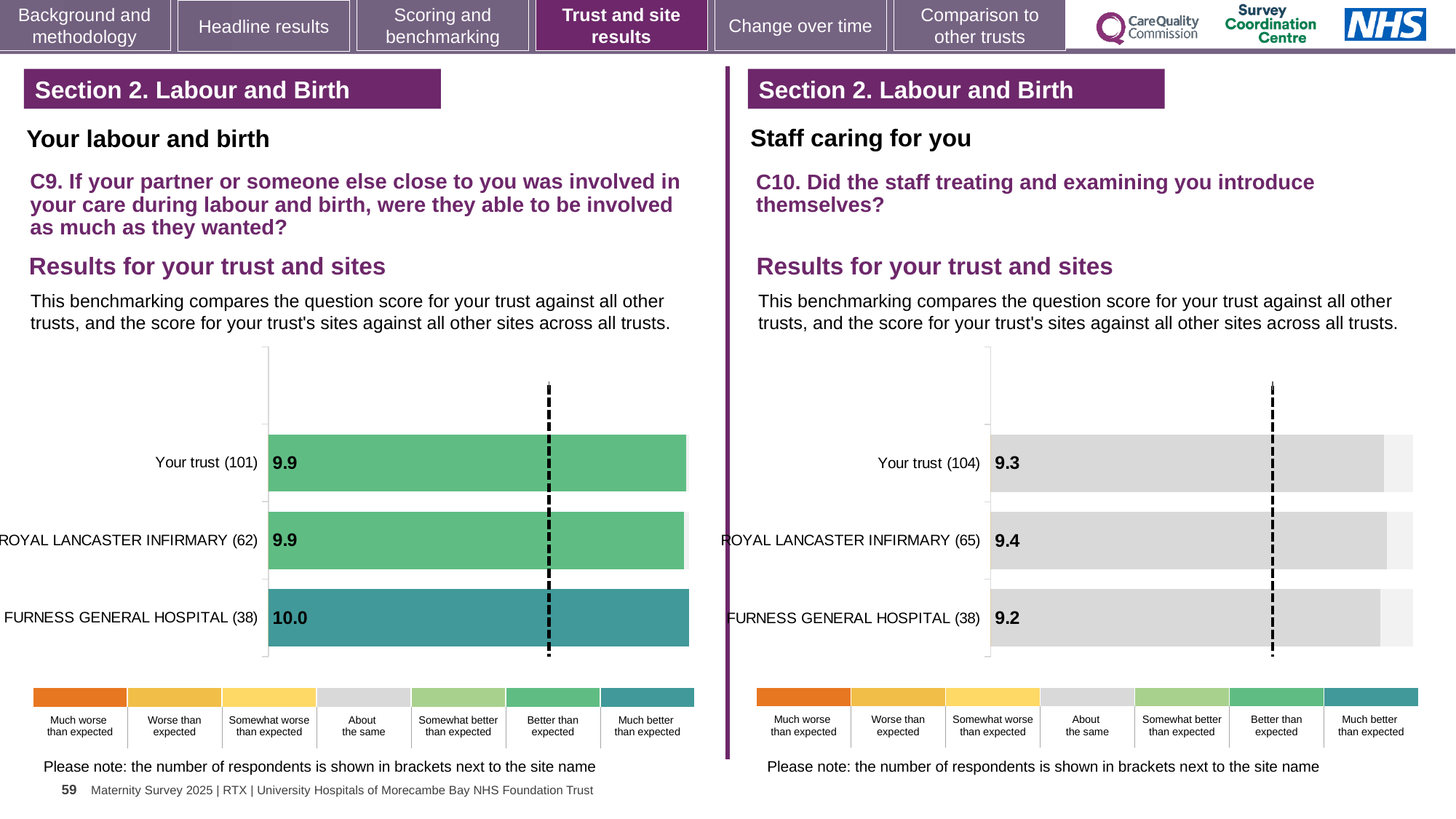
In the C9 chart on the left, what is the score for FURNESS GENERAL HOSPITAL (38)? 10.0 How many bars are shown in the C9 chart on the left? 3 In the C9 chart on the left, which has the larger score: Your trust (101) or FURNESS GENERAL HOSPITAL (38)? FURNESS GENERAL HOSPITAL (38) How many benchmark categories does the colour key below the C9 chart on the left list? 7 In the C10 chart on the right, what is the difference between the scores for ROYAL LANCASTER INFIRMARY (65) and FURNESS GENERAL HOSPITAL (38)? 0.2 In the C9 chart on the left, which site or trust has the highest score? FURNESS GENERAL HOSPITAL (38) In the C10 chart on the right, which site or trust has the lowest score? FURNESS GENERAL HOSPITAL (38) What kind of chart is used for the C10 results on the right? Bar chart In the C10 chart on the right, which site or trust has the highest score? ROYAL LANCASTER INFIRMARY (65) In the C10 chart on the right, what is the score for Your trust (104)? 9.3 In the C10 chart on the right, what is the score for ROYAL LANCASTER INFIRMARY (65)? 9.4 In the C9 chart on the left, what is the score for Your trust (101)? 9.9